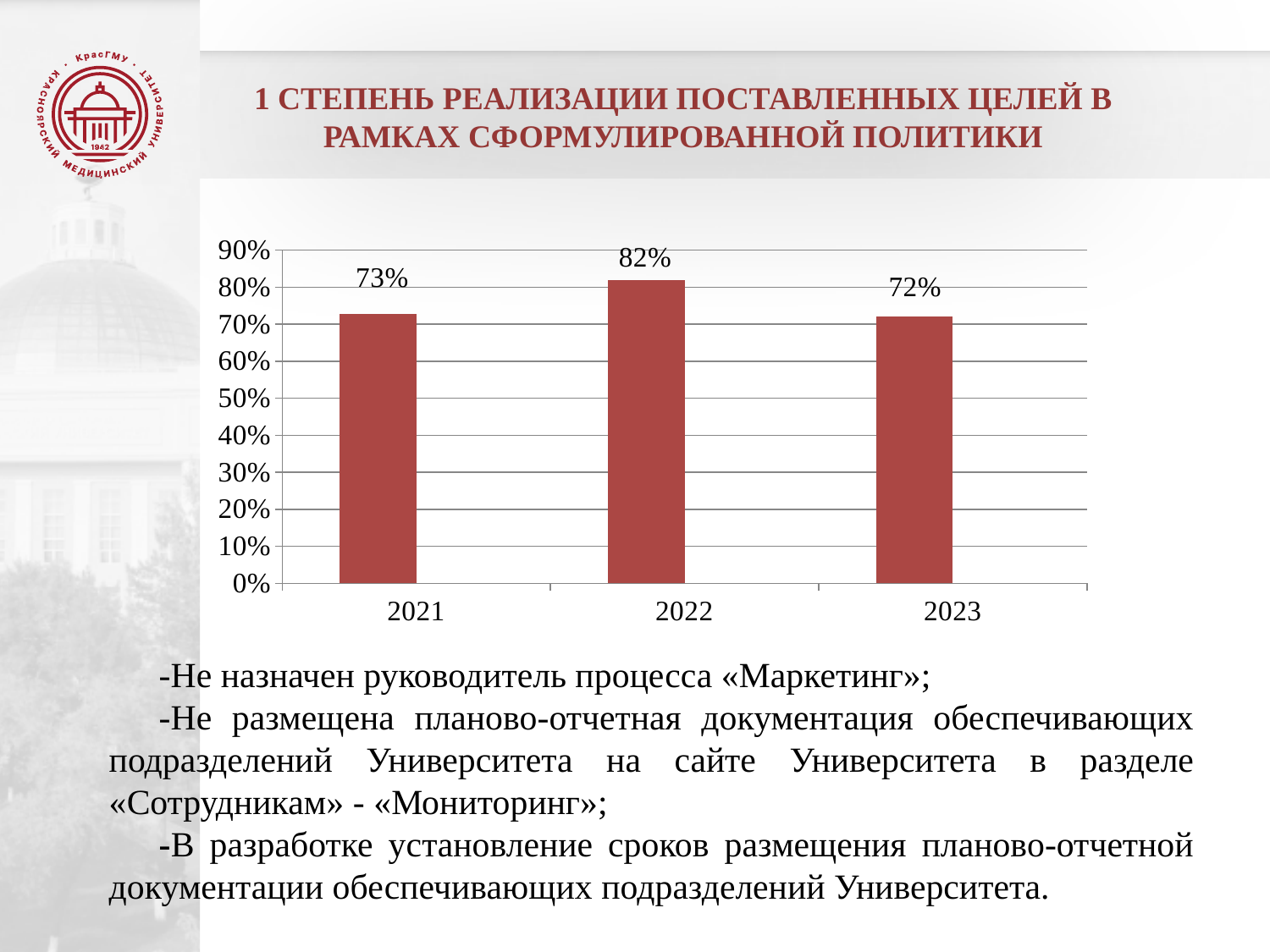
What is the value for 2023? 72% What is the difference between the values for 2022 and 2021? 9% Which is larger, the value for 2021 or the value for 2022? 2022 Is the value for 2022 greater or less than 80%? greater Which year has the highest value? 2022 How many years are shown on the x axis? 3 What is the value for 2021? 73% What is the highest value shown on the y axis? 90% What kind of chart is shown on the slide? bar chart Which year has the lowest value? 2023 What is the value for 2022? 82% What is the difference between the values for 2022 and 2023? 10%